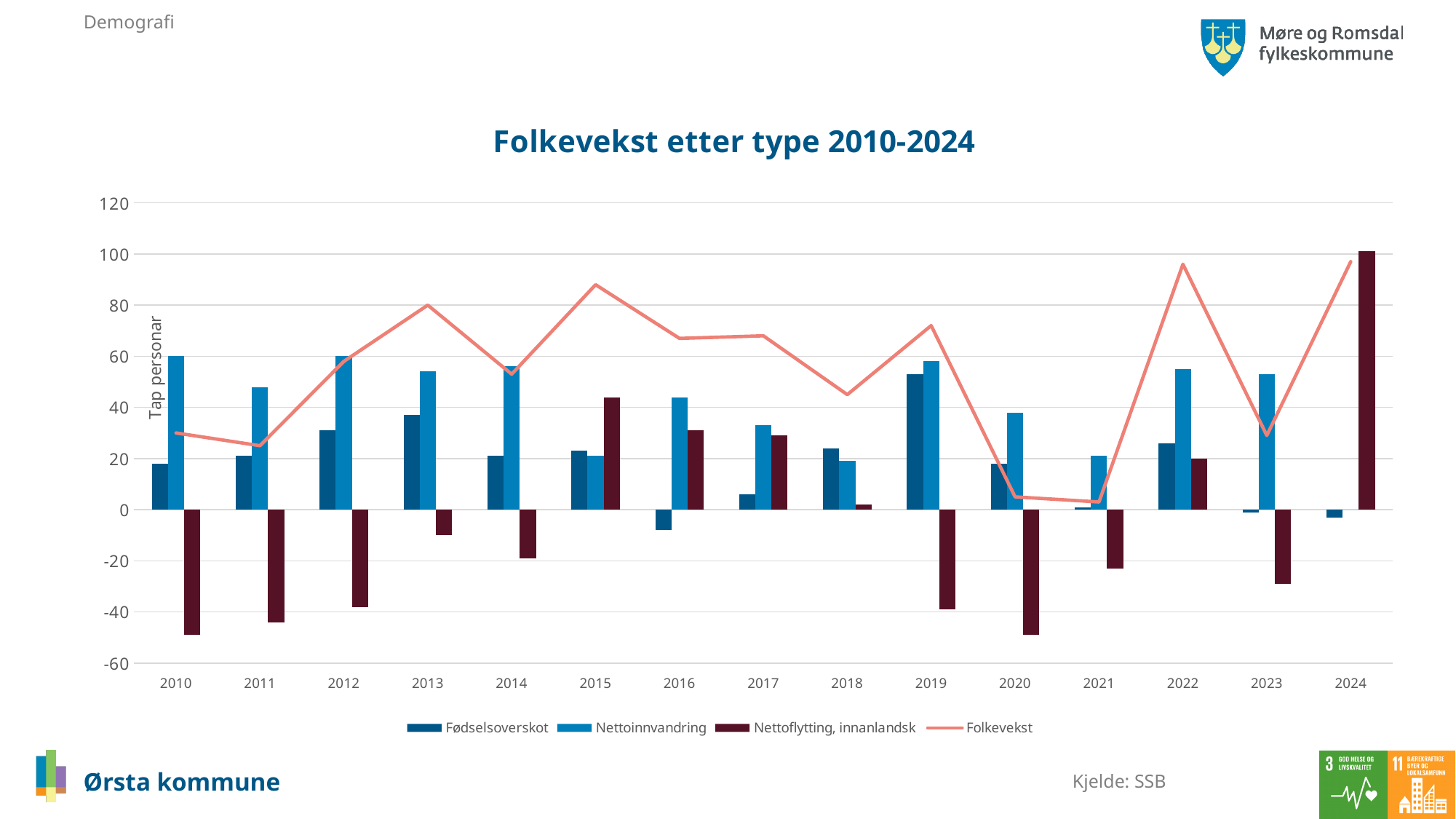
In 2015, which is larger: Nettoinnvandring or Nettoflytting, innanlandsk? Nettoflytting, innanlandsk How many series does the legend list? 4 Is the value for Nettoinnvandring in 2010 greater or less than 40? greater Is the Folkevekst value in 2020 greater or less than 20? less Is the value for Nettoflytting, innanlandsk in 2010 greater or less than -40? less What is the title of the chart? Folkevekst etter type 2010-2024 How many years are shown on the x axis? 15 Does the Folkevekst line rise or fall from 2019 to 2021? fall In which year is Nettoflytting, innanlandsk highest? 2024 In which year is Fødselsoverskot highest? 2019 What kind of chart is shown on the slide? bar chart with a line